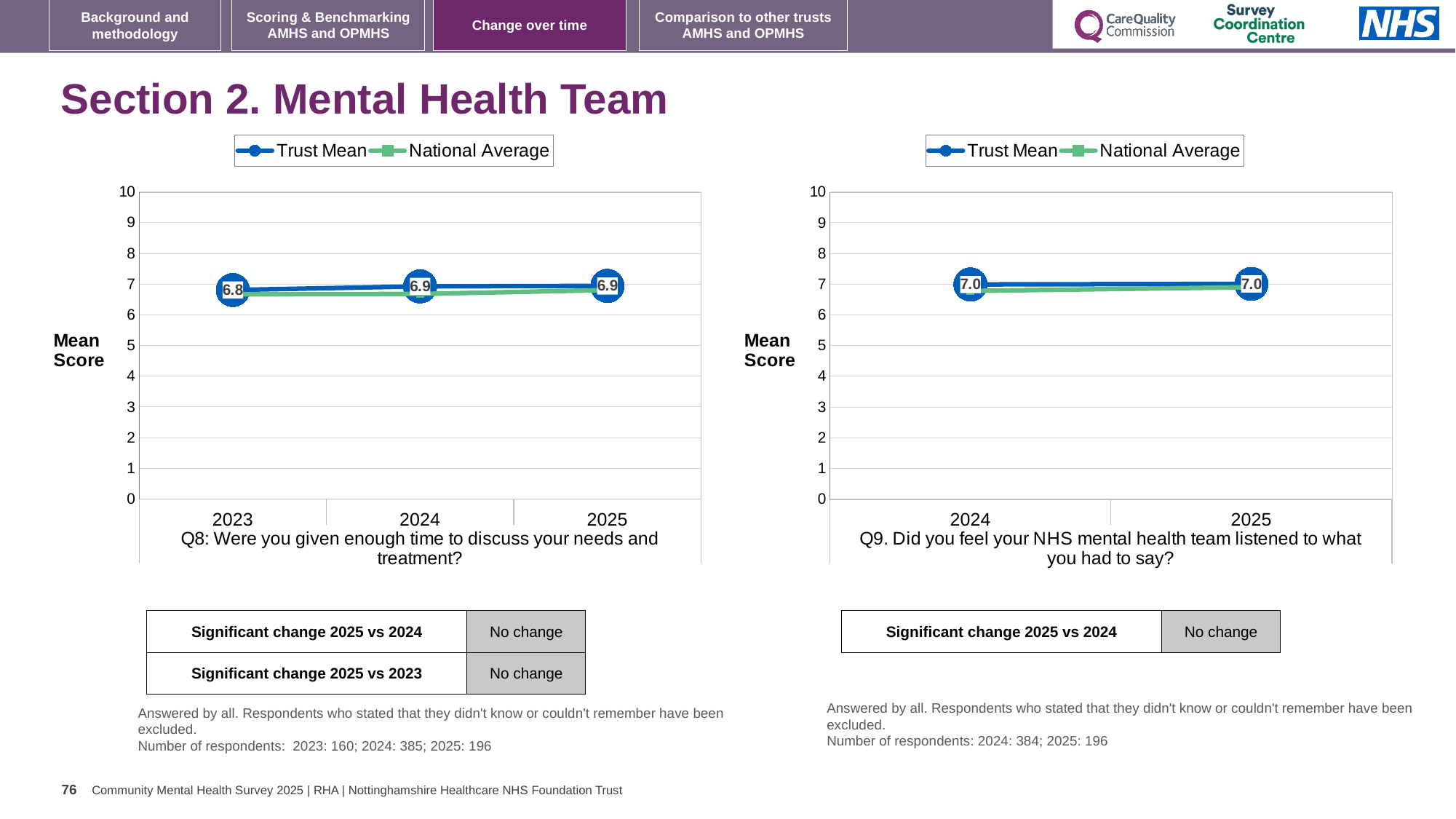
In the left chart (Q8), does the Trust Mean rise or fall from 2023 to 2025? rise In the left chart (Q8), what is the Trust Mean for 2023? 6.8 How many series does the legend of the right chart (Q9) list? 2 In the left chart (Q8), is the Trust Mean for 2025 larger or smaller than for 2023? larger In the left chart (Q8), what is the difference between the Trust Mean for 2025 and for 2023? 0.1 What kind of chart is the left chart (Q8)? line chart In the left chart (Q8), what is the Trust Mean for 2025? 6.9 In the left chart (Q8), which year has the lowest Trust Mean? 2023 In the right chart (Q9), is the National Average for 2025 greater or less than 5? greater How many years are plotted on the x axis of the left chart (Q8)? 3 In the right chart (Q9), what is the Trust Mean for 2025? 7.0 In the right chart (Q9), what is the Trust Mean for 2024? 7.0